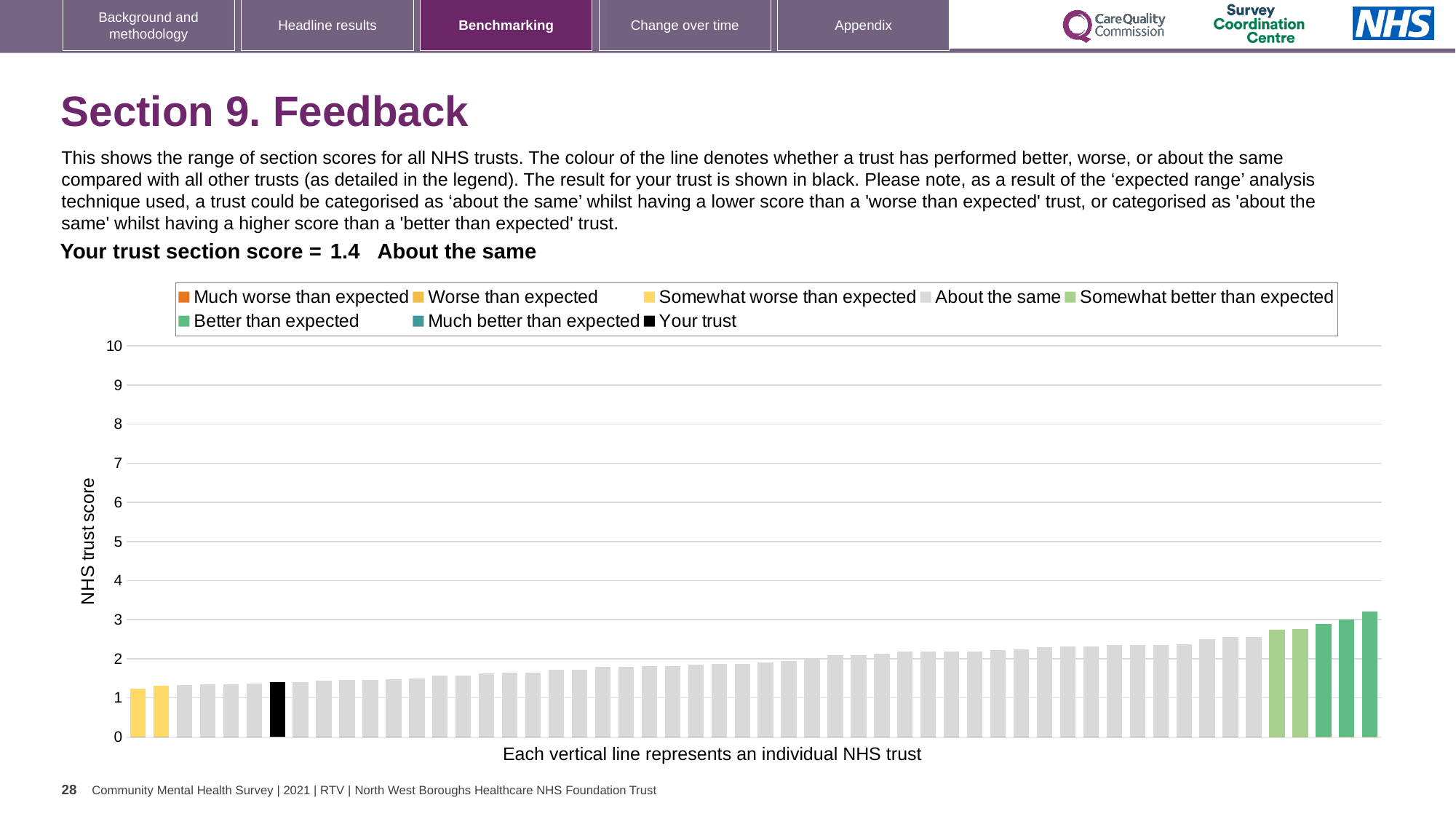
Is the value of the shortest bar in the chart greater or less than 2? less Which category is your trust placed in according to the slide? About the same Is the value of the black 'Your trust' bar greater or less than 2? less What kind of chart is shown on the slide? bar chart What is the label on the y axis of the chart? NHS trust score What is the section score for your trust shown on the slide? 1.4 How many entries does the chart legend list? 8 Do the bar values rise or fall from left to right along the x axis? rise Which legend category does the shortest bar belong to? Somewhat worse than expected Which legend category does the tallest bar belong to? Better than expected Is the value of the tallest bar in the chart greater or less than 3? greater How many bars are coloured yellow (Somewhat worse than expected)? 2